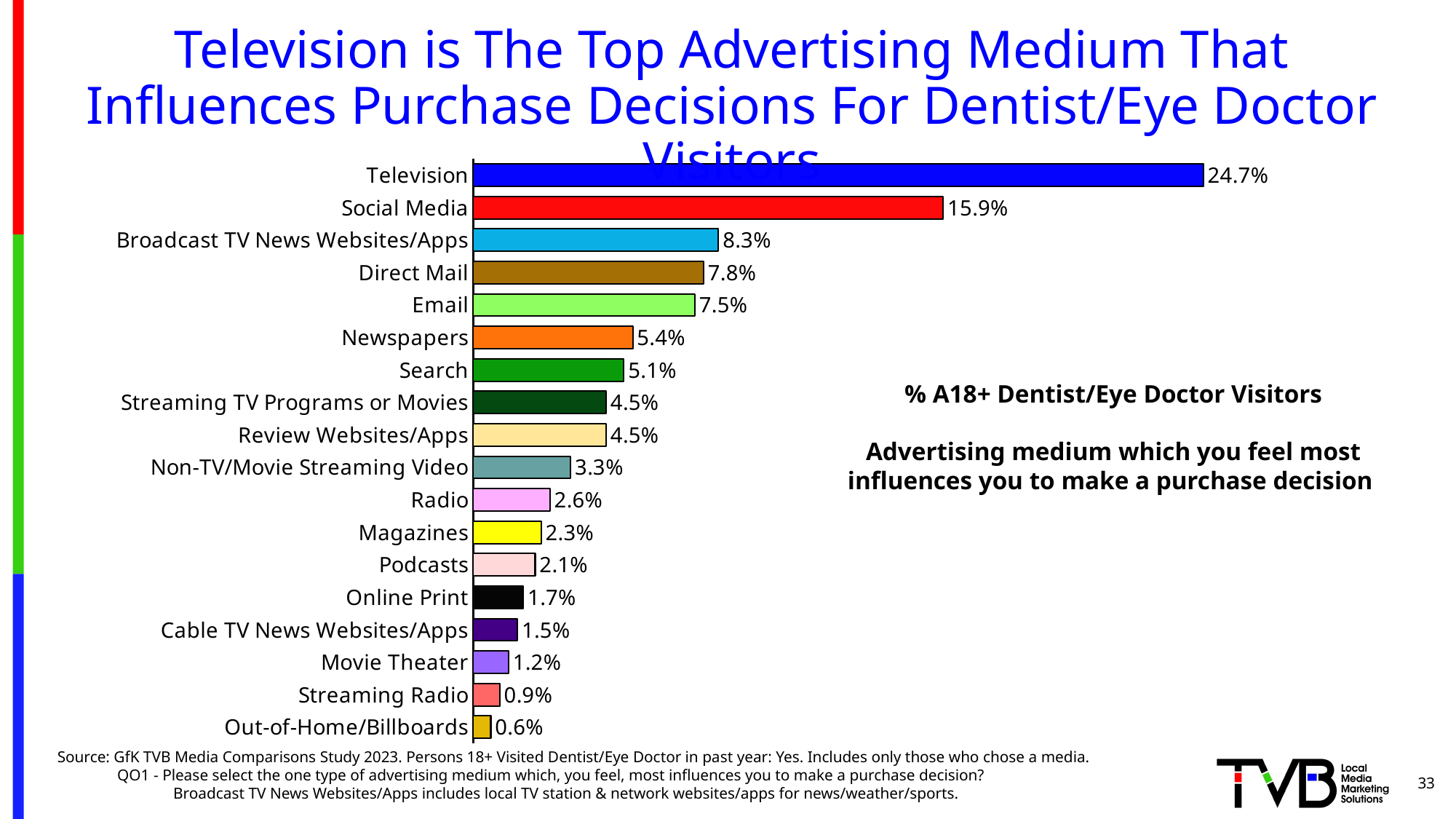
Which has a larger value, Radio or Magazines? Radio Which has a larger value, Email or Broadcast TV News Websites/Apps? Broadcast TV News Websites/Apps Which advertising medium has the lowest value on the chart? Out-of-Home/Billboards How many advertising media categories are shown on the chart? 18 What is the value shown for Podcasts? 2.1% What colour is the bar for Social Media? Red What is the difference between the values for Television and Social Media? 8.8% What kind of chart is shown on the slide? Bar chart What is the value shown for Direct Mail? 7.8% What is the difference between the values for Newspapers and Search? 0.3% What percentage of A18+ Dentist/Eye Doctor Visitors chose Television as the advertising medium that most influences their purchase decision? 24.7% Which advertising medium has the highest value on the chart? Television